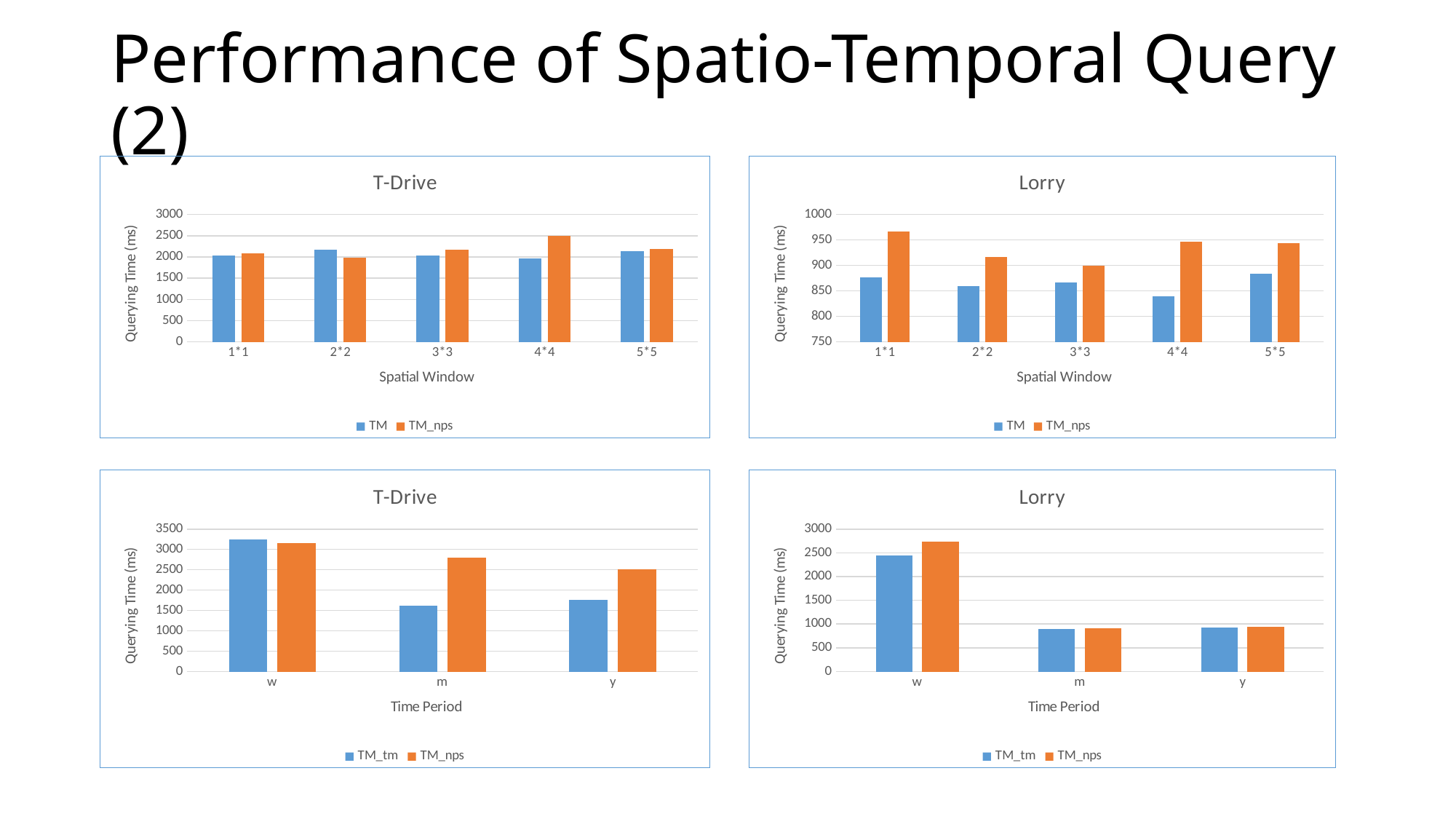
In the bottom-left T-Drive chart, which time period has the lowest TM_tm querying time? m How many spatial window categories are shown in the top-left T-Drive chart? 5 In the top-left T-Drive chart, which spatial window has the highest TM_nps querying time? 4*4 In the bottom-right Lorry chart, which time period has the highest TM_nps querying time? w What are the two legend entries in the bottom-left T-Drive chart? TM_tm and TM_nps What type of chart is the bottom-right Lorry chart? bar chart In the top-right Lorry chart, which spatial window has the lowest TM querying time? 4*4 In the top-right Lorry chart, which is larger at 1*1, TM or TM_nps? TM_nps How many series does the legend of the top-right Lorry chart list? 2 In the top-left T-Drive chart, is the TM_nps value for 4*4 greater or less than 2000? greater In the bottom-left T-Drive chart, is the TM_nps value for m greater or less than 2500? greater In the top-right Lorry chart, is the TM value for 4*4 greater or less than 850? less